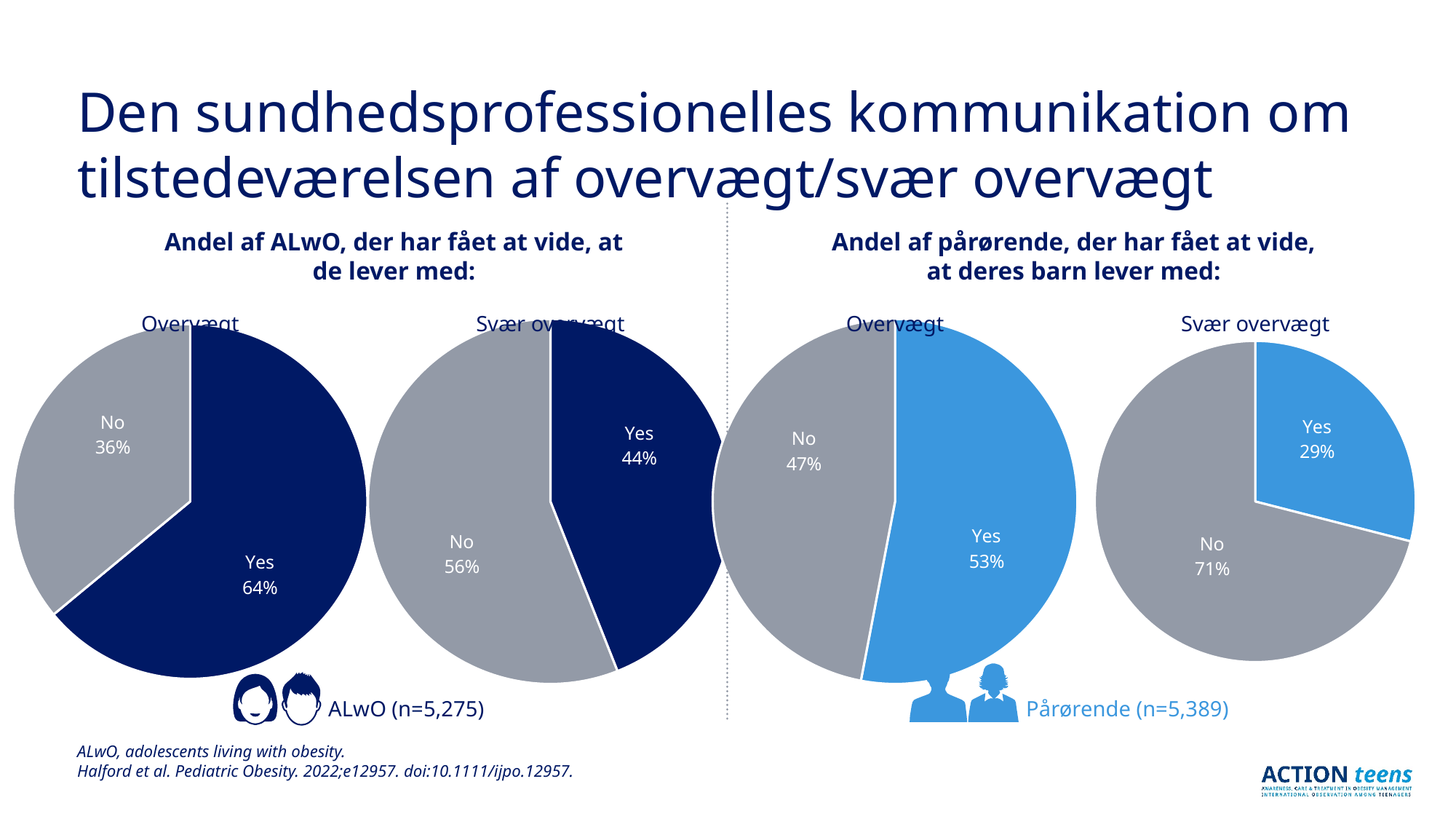
In the ALwO 'Overvægt' pie chart (leftmost), what percentage answered No? 36% In the ALwO 'Svær overvægt' pie chart (second from left), what is the difference between the No and Yes shares? 12% In the Pårørende 'Overvægt' pie chart (third from left), what percentage answered No? 47% What is the sample size (n) shown for the Pårørende group? n=5,389 What is the difference between the Yes share in the ALwO 'Overvægt' pie chart and the Yes share in the Pårørende 'Overvægt' pie chart? 11% What type of charts are shown on the slide? Pie charts How many slices does the Pårørende 'Overvægt' pie chart (third from left) have? 2 In the Pårørende 'Svær overvægt' pie chart (rightmost), what percentage answered Yes? 29% In the Pårørende 'Svær overvægt' pie chart (rightmost), which slice is larger, Yes or No? No In the ALwO 'Svær overvægt' pie chart (second from left), what percentage answered Yes? 44% In the ALwO 'Overvægt' pie chart (leftmost), what percentage answered Yes? 64% How many pie charts are shown on the slide? 4